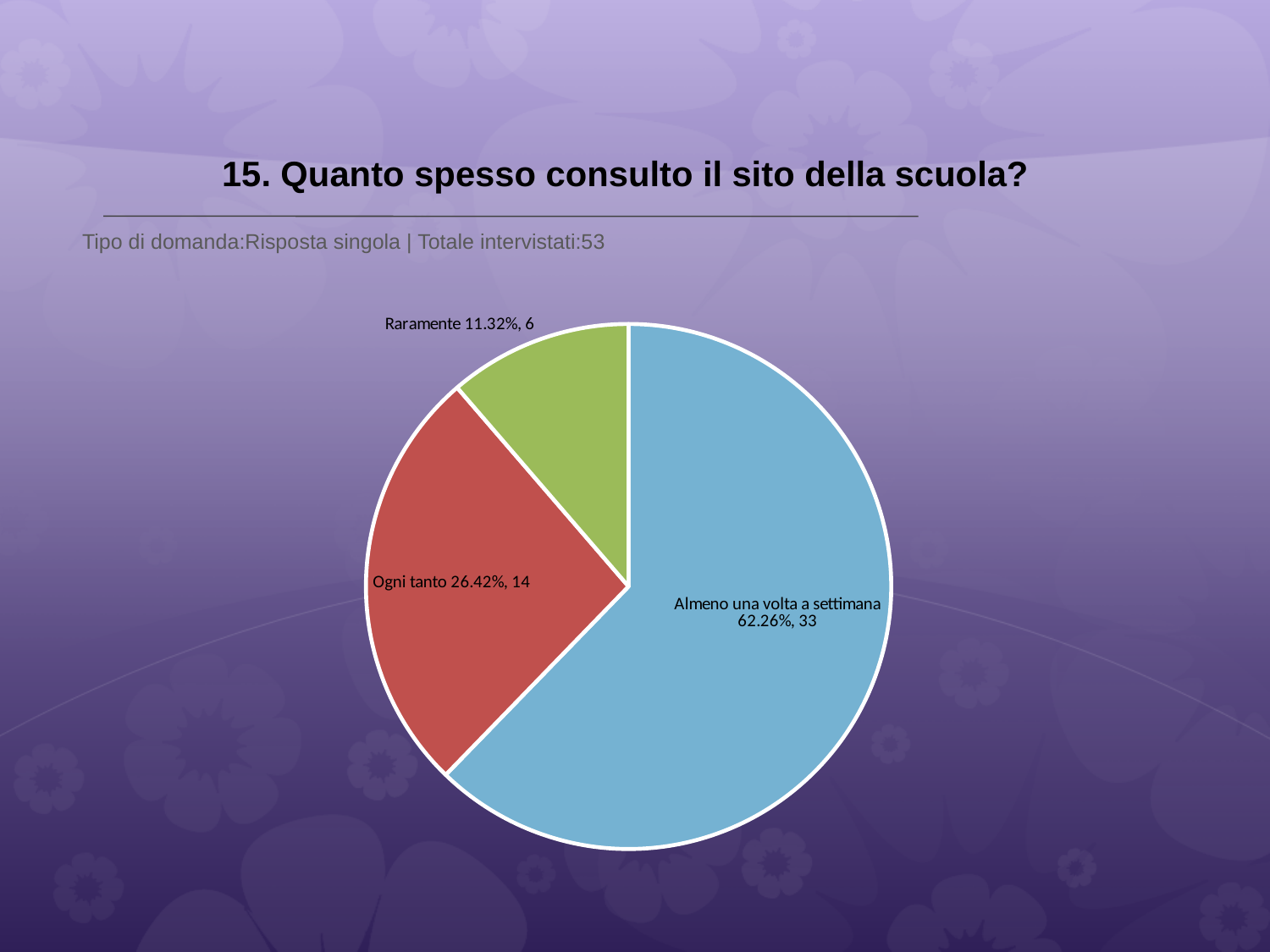
Which has more respondents, 'Ogni tanto' or 'Raramente'? Ogni tanto What kind of chart is shown on the slide? pie chart What percentage share does the 'Almeno una volta a settimana' slice have? 62.26% What percentage share does the 'Raramente' slice have? 11.32% How many slices does the pie chart have? 3 What is the total number of respondents across all slices? 53 How many respondents chose 'Raramente'? 6 Which category has the smallest slice? Raramente What is the difference in respondent count between 'Almeno una volta a settimana' and 'Ogni tanto'? 19 What is the title of the chart on the slide? 15. Quanto spesso consulto il sito della scuola? How many respondents chose 'Ogni tanto'? 14 Which category has the largest slice? Almeno una volta a settimana